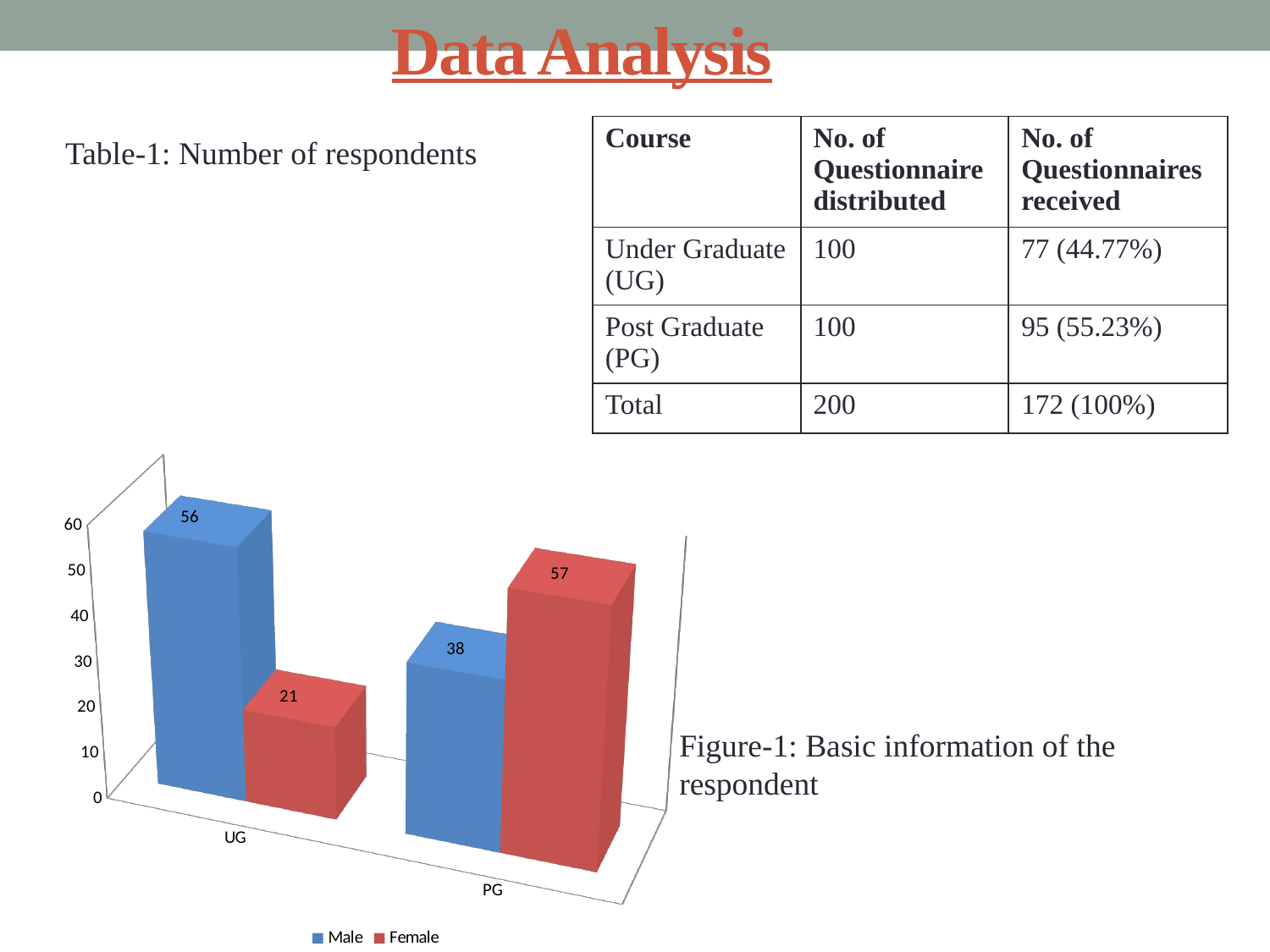
What kind of chart is shown on the slide? Bar chart What is the Female value for UG in the chart? 21 What is the difference between the Male and Female values for UG? 35 What is the difference between the Female values for PG and UG? 36 How many categories are shown on the x axis of the chart? 2 What is the Male value for UG in the chart? 56 What is the Female value for PG in the chart? 57 Which category has the lowest Female value in the chart? UG What is the Male value for PG in the chart? 38 Which category has the highest Male value in the chart? UG How many series does the chart legend list? 2 Which is larger for PG: the Male value or the Female value? Female